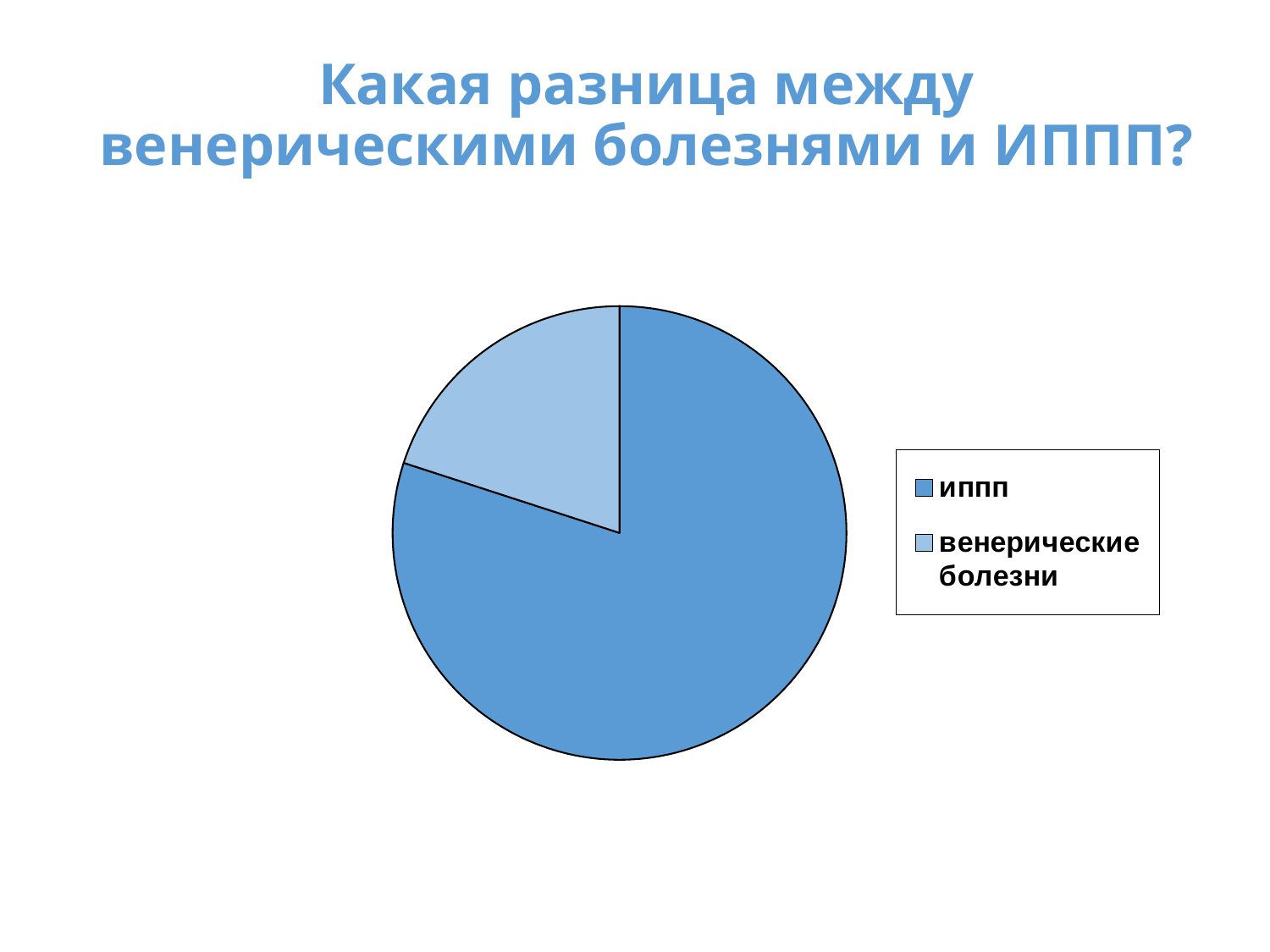
How many slices does the pie chart have? 2 How many entries does the legend of the pie chart list? 2 Which category has the smallest slice in the pie chart? венерические болезни Which slice is larger: ИППП or венерические болезни? ИППП Which legend entry is shown in the lighter blue colour? венерические болезни Does the ИППП slice take up more or less than half of the pie? more What kind of chart is shown on the slide? pie chart What is the first entry listed in the legend? ИППП Which category has the largest slice in the pie chart? ИППП